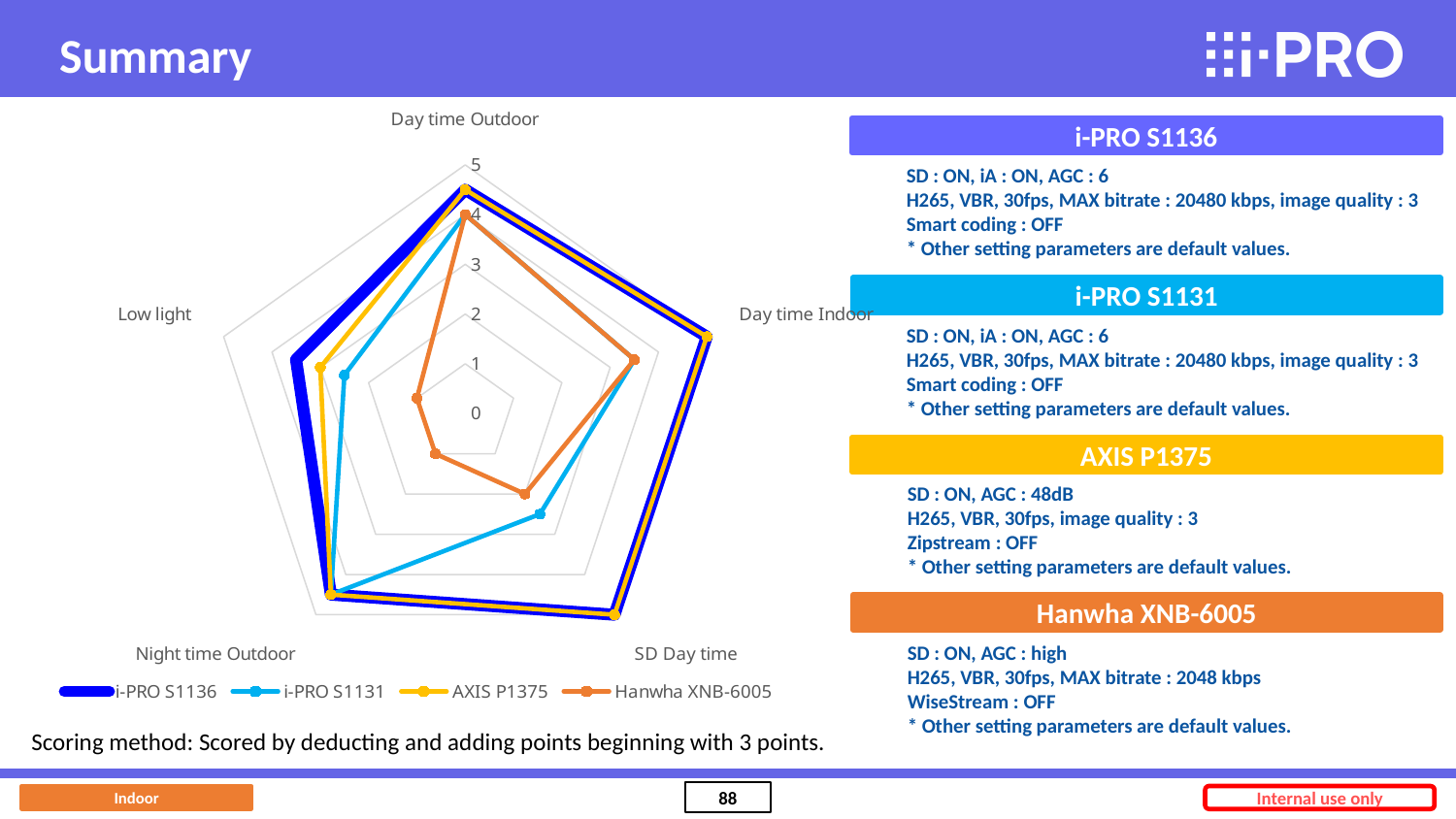
How many series does the chart legend list? 4 Which series has the lowest score for Night time Outdoor? Hanwha XNB-6005 Is the Day time Indoor score for Hanwha XNB-6005 greater or less than 5? less Is the Low light score for i-PRO S1136 greater or less than 3? greater Which series is drawn in orange on the chart? Hanwha XNB-6005 What score does Hanwha XNB-6005 have for Night time Outdoor? 1 What kind of chart is shown on the slide? radar chart What score does Hanwha XNB-6005 have for Low light? 1 Which is larger for SD Day time: the score of i-PRO S1136 or the score of Hanwha XNB-6005? i-PRO S1136 What is the maximum value shown on the radar chart's scale? 5 How many categories (axes) does the radar chart have? 5